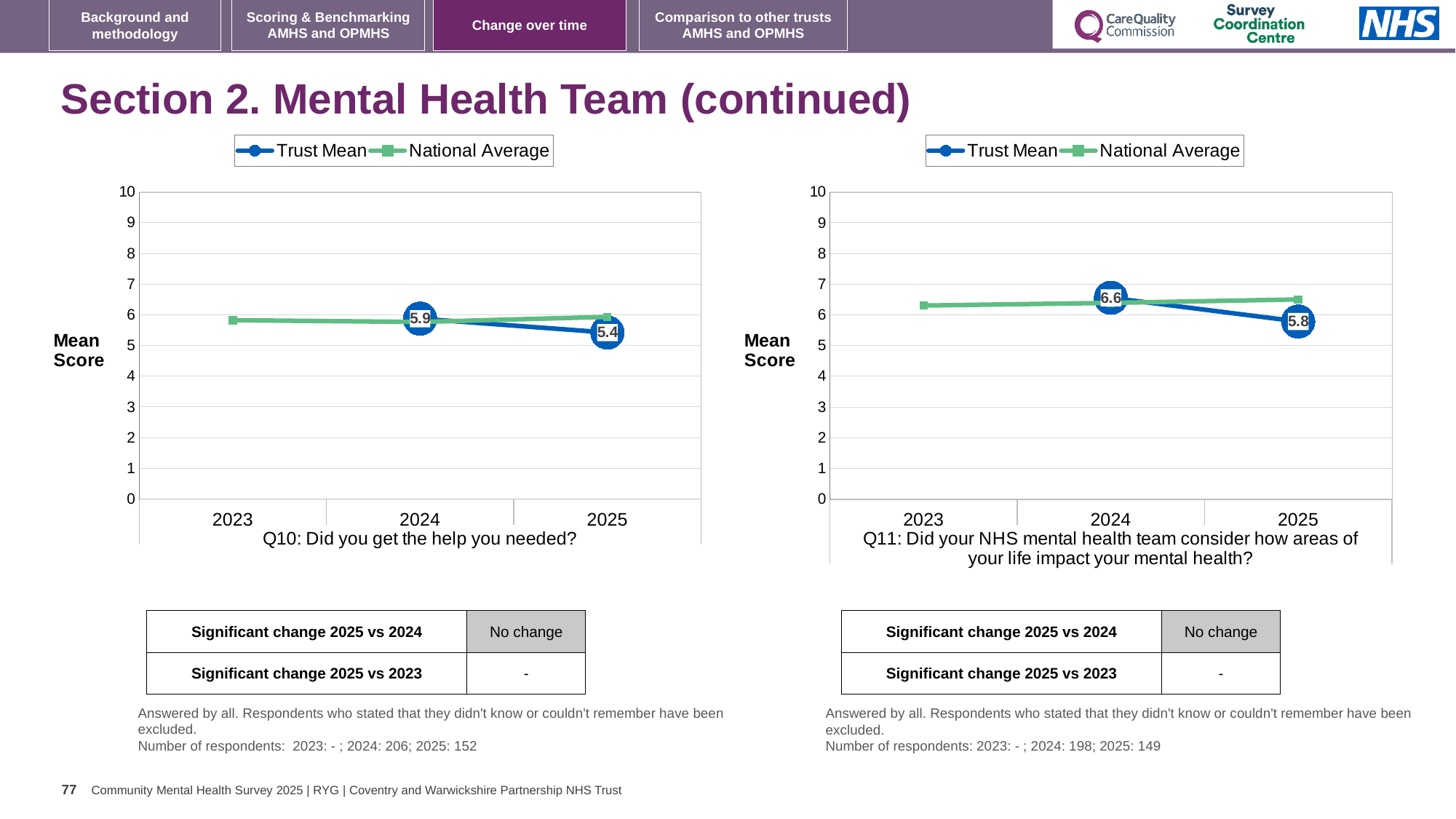
On the Q10 chart (left), by how much did the Trust Mean change from 2024 to 2025? 0.5 On the Q11 chart (right), is the National Average for 2025 greater or less than 6? greater On the Q11 chart (right), what is the Trust Mean for 2025? 5.8 How many years are shown on the x axis of the Q11 chart (right)? 3 On the Q10 chart (left), what is the Trust Mean for 2025? 5.4 How many series does the legend of the Q10 chart (left) list? 2 What type of chart is the Q10 chart (left)? line chart On the Q11 chart (right), what is the Trust Mean for 2024? 6.6 On the Q10 chart (left), which year has the higher Trust Mean, 2024 or 2025? 2024 On the Q11 chart (right), what is the difference between the Trust Mean in 2024 and in 2025? 0.8 On the Q11 chart (right), does the Trust Mean rise or fall from 2024 to 2025? fall On the Q10 chart (left), what is the Trust Mean for 2024? 5.9